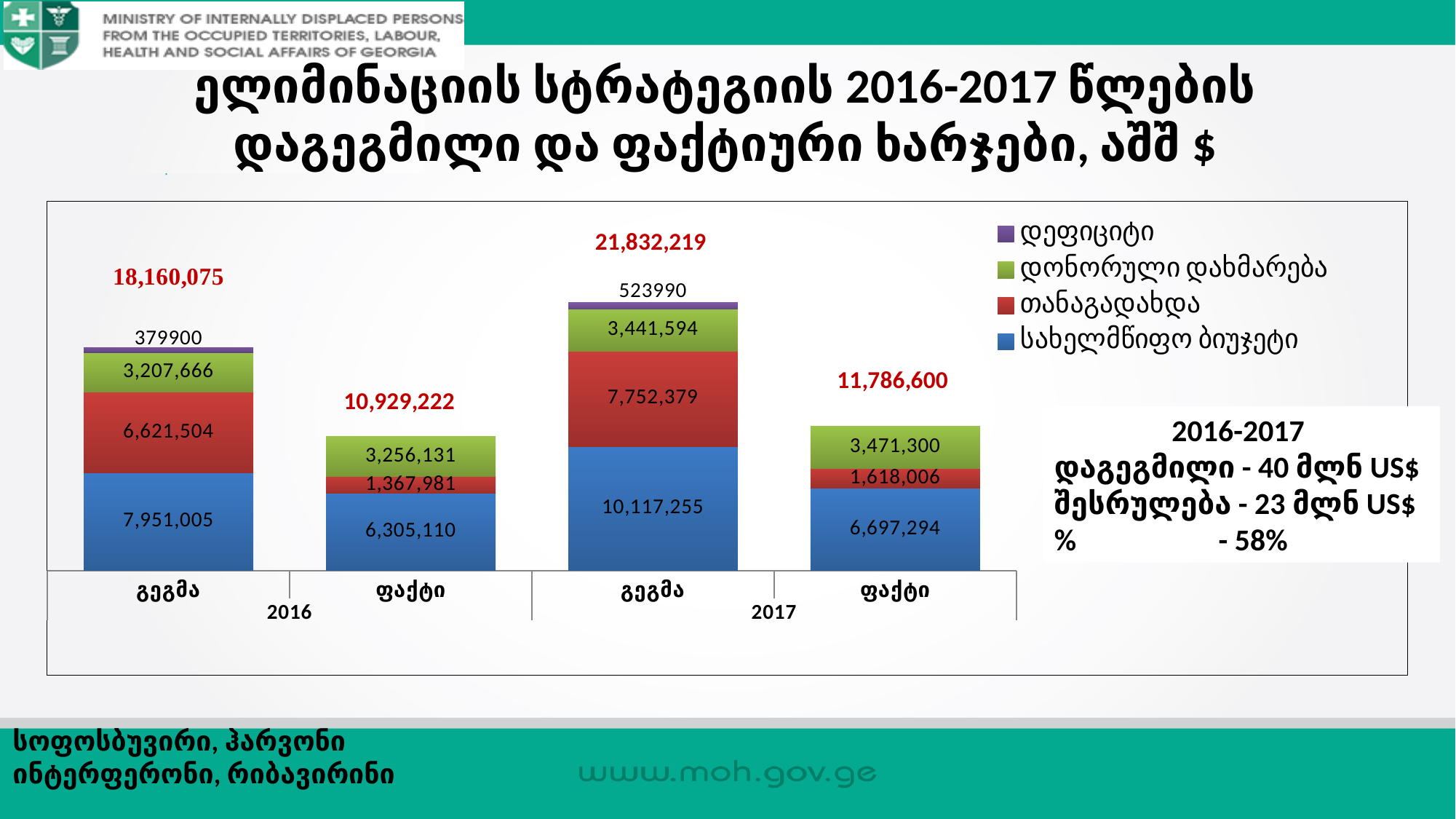
What is the total shown above the 2017 გეგმა bar? 21,832,219 Which bar has the highest total? 2017 გეგმა What is the value of the სახელმწიფო ბიუჯეტი (blue) segment for the 2016 გეგმა bar? 7,951,005 How many series does the chart legend list? 4 What is the value of the თანაგადახდა (red) segment for the 2017 ფაქტი bar? 1,618,006 Which bar has the lowest total? 2016 ფაქტი How many bars are plotted in the chart? 4 What kind of chart is shown on the slide? stacked bar chart Which is larger: the თანაგადახდა value for 2016 გეგმა or for 2016 ფაქტი? 2016 გეგმა What is the difference between the სახელმწიფო ბიუჯეტი values of the 2017 გეგმა bar and the 2017 ფაქტი bar? 3,419,961 What is the value of the დეფიციტი (purple) segment for the 2017 გეგმა bar? 523990 What is the value of the დონორული დახმარება (green) segment for the 2016 ფაქტი bar? 3,256,131